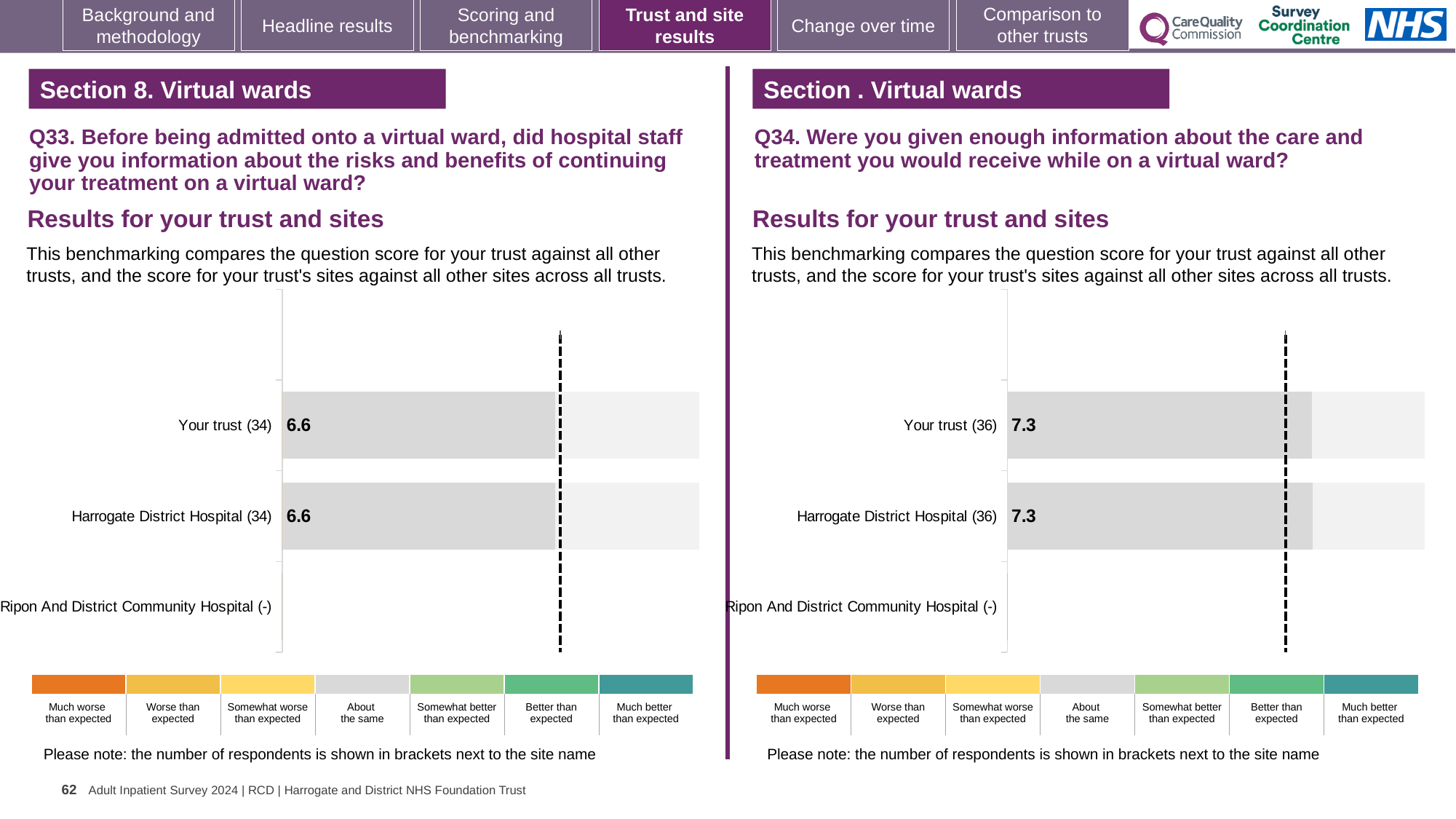
On the Q34 chart (right), what is the score for Your trust? 7.3 On the Q33 chart (left), how many respondents are shown in brackets for Your trust? 34 Is the Q34 (right) score for Your trust larger or smaller than the Q33 (left) score for Your trust? Larger On the Q34 chart (right), what is the difference between the scores for Your trust and Harrogate District Hospital? 0 On the Q34 chart (right), what is the score for Harrogate District Hospital? 7.3 On the Q33 chart (left), what is the score for Harrogate District Hospital? 6.6 On the Q33 chart (left), what is the score for Your trust? 6.6 On the Q33 chart (left), what is the difference between the scores for Your trust and Harrogate District Hospital? 0 On the Q34 chart (right), how many respondents are shown in brackets for Harrogate District Hospital? 36 What kind of chart is used on the Q33 chart (left)? Bar chart How many site/trust categories are listed on the Q34 chart (right)? 3 How many site/trust categories are listed on the Q33 chart (left)? 3